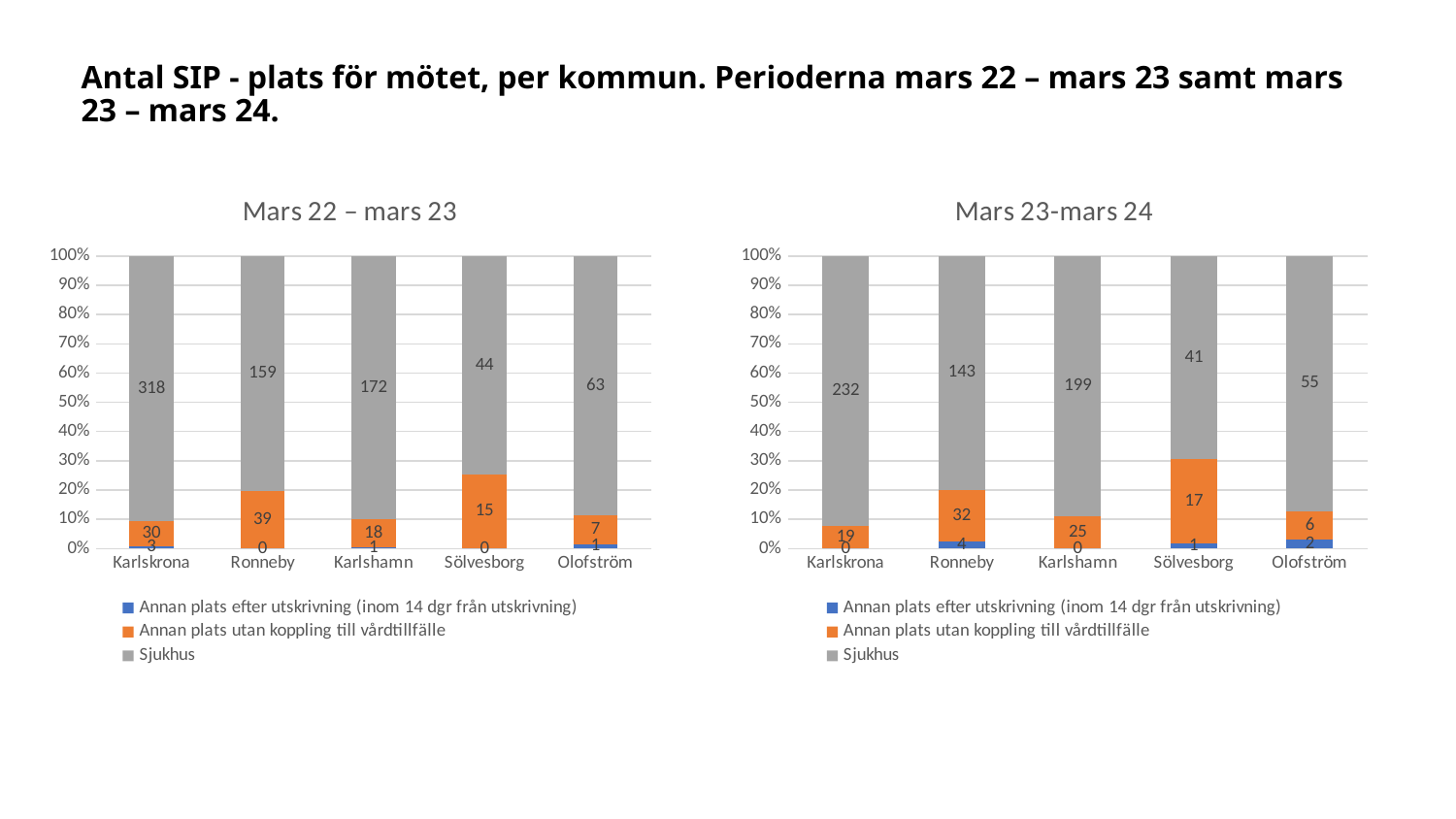
In the 'Mars 23-mars 24' chart, which is larger: the 'Annan plats utan koppling till vårdtillfälle' value for Ronneby or for Karlshamn? Ronneby In the 'Mars 23-mars 24' chart, which kommun has the lowest Sjukhus value? Sölvesborg In the 'Mars 22 – mars 23' chart, what is the value of 'Annan plats utan koppling till vårdtillfälle' for Ronneby? 39 How many series does the legend of the 'Mars 23-mars 24' chart list? 3 What kind of chart is the 'Mars 22 – mars 23' chart? Stacked bar chart In the 'Mars 23-mars 24' chart, what is the value of 'Annan plats efter utskrivning (inom 14 dgr från utskrivning)' for Ronneby? 4 What is the difference between the Sjukhus value for Karlskrona in the 'Mars 22 – mars 23' chart and in the 'Mars 23-mars 24' chart? 86 In the 'Mars 22 – mars 23' chart, what is the Sjukhus value for Karlskrona? 318 In the 'Mars 23-mars 24' chart, what is the Sjukhus value for Karlshamn? 199 How many kommuner are shown on the x axis of the 'Mars 22 – mars 23' chart? 5 In the 'Mars 22 – mars 23' chart, which kommun has the highest Sjukhus value? Karlskrona In the 'Mars 23-mars 24' chart, what is the total of the three values stacked for Ronneby? 179